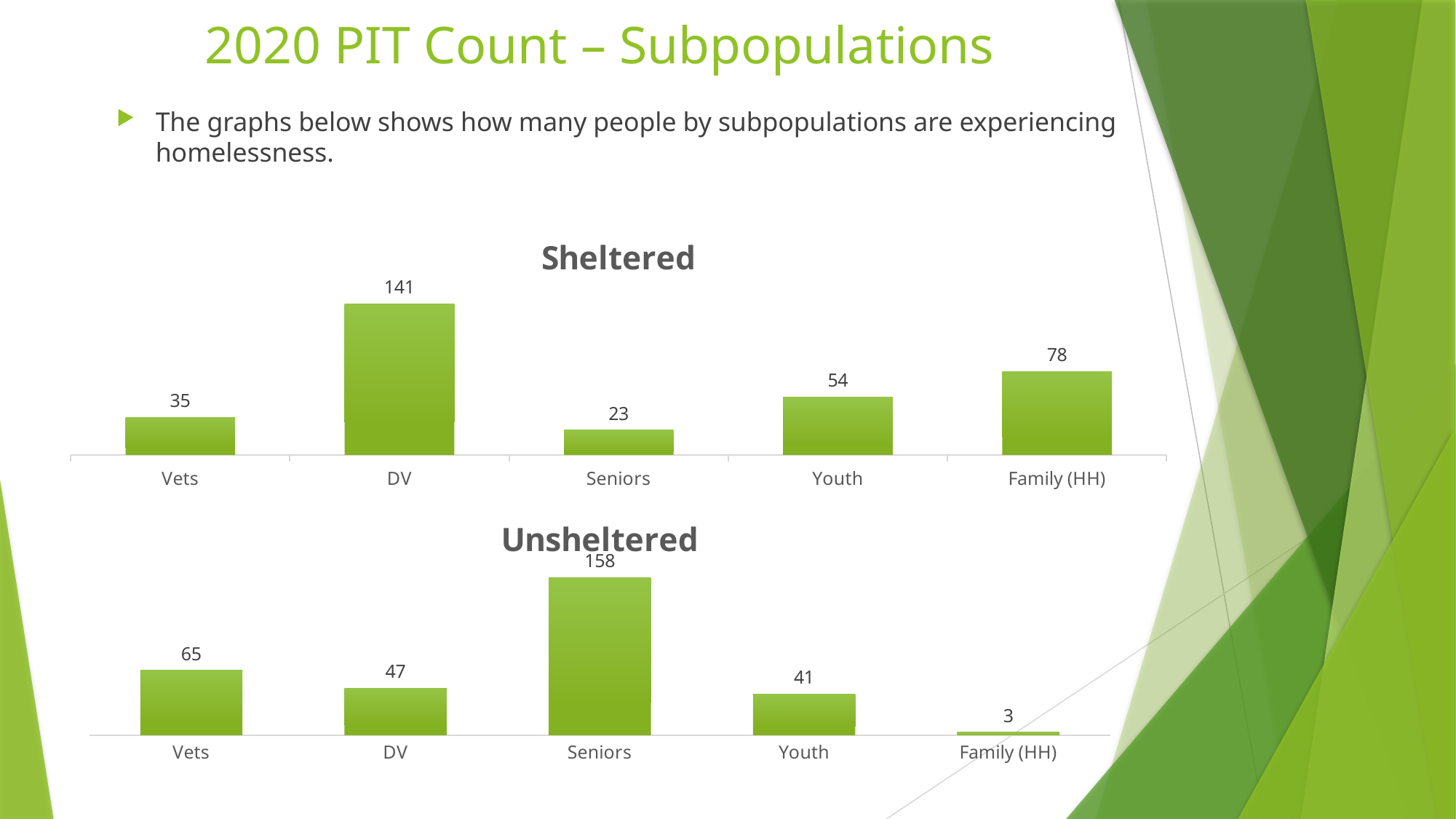
In the Sheltered chart, what is the value for DV? 141 In the Unsheltered chart, which category has the highest value? Seniors In the Unsheltered chart, which category has the lowest value? Family (HH) In the Sheltered chart, what is the value for Seniors? 23 How many categories are shown in the Unsheltered chart? 5 What kind of chart is the Sheltered chart? Bar chart In the Unsheltered chart, what is the value for Family (HH)? 3 In the Sheltered chart, what is the difference between the values for Family (HH) and Youth? 24 In the Unsheltered chart, what is the value for Vets? 65 In the Unsheltered chart, what is the difference between the values for Seniors and DV? 111 In the Sheltered chart, which is larger, the value for Vets or the value for Seniors? Vets In the Sheltered chart, which category has the highest value? DV